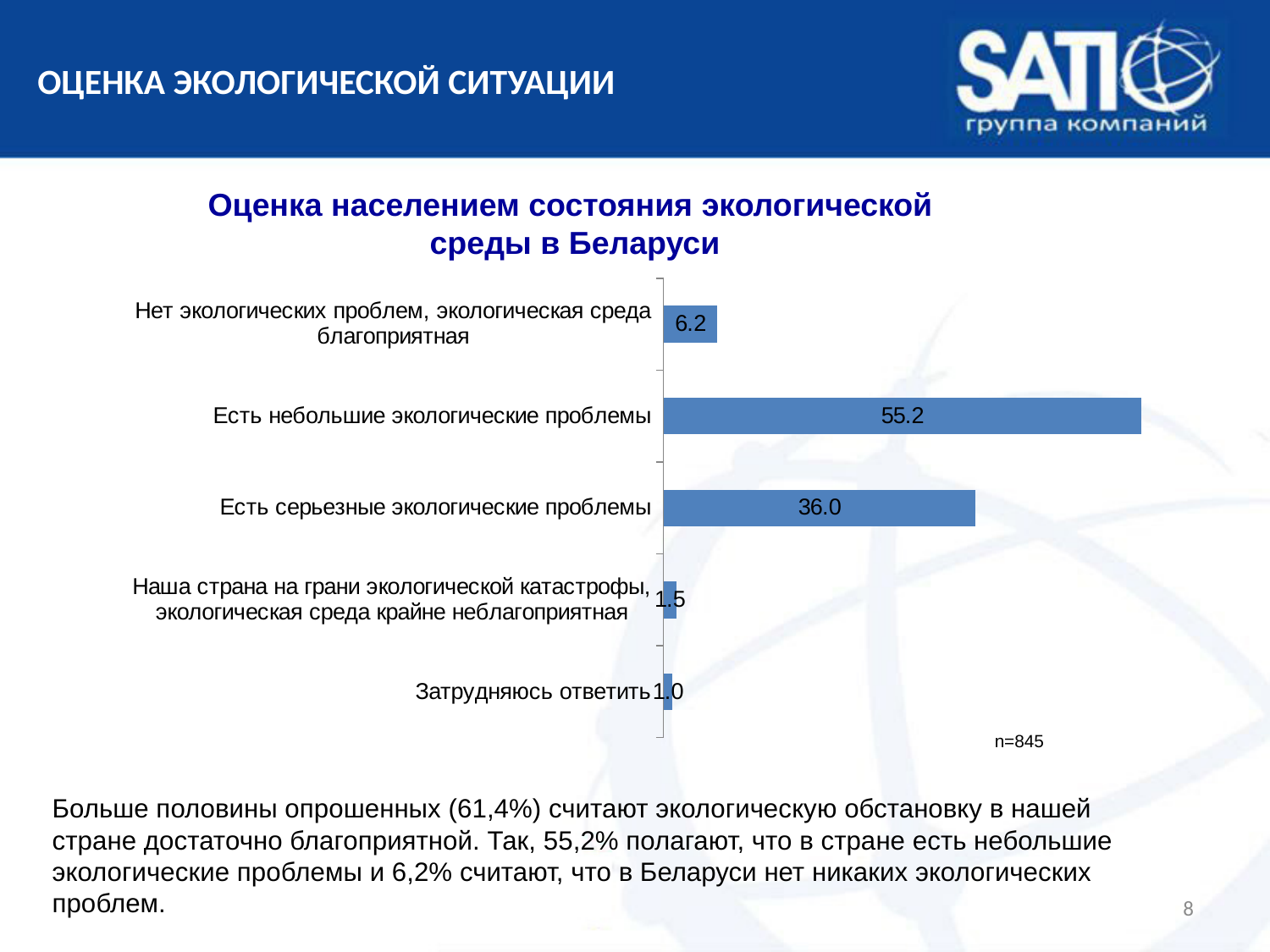
Which category has the lowest value? Затрудняюсь ответить Which category has the highest value? Есть небольшие экологические проблемы Which is larger: the value for "Нет экологических проблем, экологическая среда благоприятная" or the value for "Наша страна на грани экологической катастрофы, экологическая среда крайне неблагоприятная"? Нет экологических проблем, экологическая среда благоприятная What kind of chart is shown on the slide? Bar chart What is the value for "Затрудняюсь ответить"? 1.0 What is the title of the chart? Оценка населением состояния экологической среды в Беларуси What sample size (n) is indicated on the chart? n=845 What is the value for "Нет экологических проблем, экологическая среда благоприятная"? 6.2 What is the value for "Есть серьезные экологические проблемы"? 36.0 How many categories are shown in the chart? 5 What is the value for "Есть небольшие экологические проблемы"? 55.2 What is the difference between the values for "Есть небольшие экологические проблемы" and "Есть серьезные экологические проблемы"? 19.2